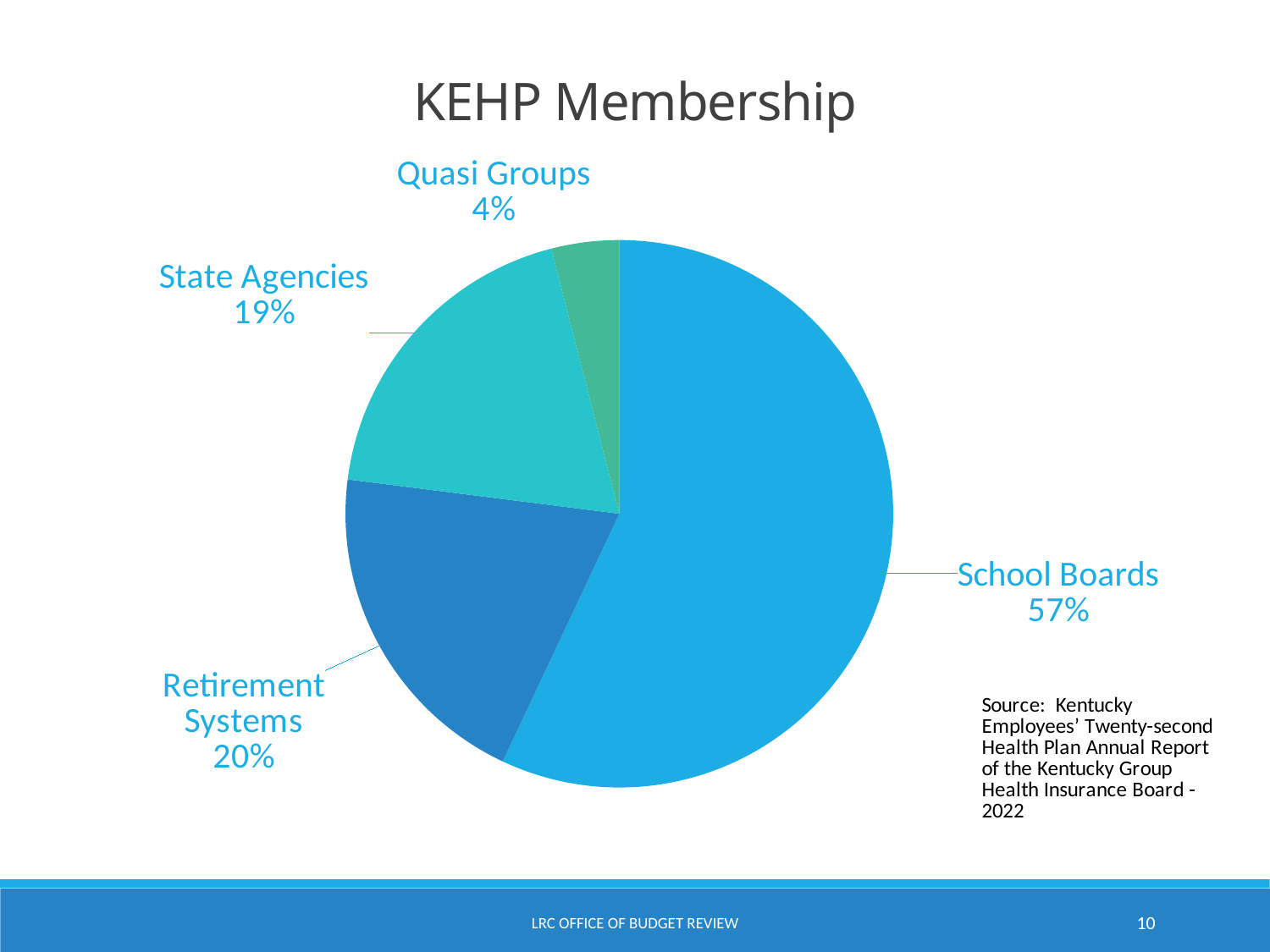
What is the title of the chart on the slide? KEHP Membership What share of KEHP membership is School Boards? 57% How many percentage points larger is the State Agencies share than the Quasi Groups share? 15 Which group has the largest share of KEHP membership? School Boards What kind of chart is used to show KEHP Membership? Pie chart How many percentage points larger is the School Boards share than the Retirement Systems share? 37 How many groups are shown in the KEHP Membership pie chart? 4 What share of KEHP membership is Retirement Systems? 20% Which group has the smallest share of KEHP membership? Quasi Groups What share of KEHP membership is State Agencies? 19% Which has a larger share of KEHP membership, Retirement Systems or State Agencies? Retirement Systems What share of KEHP membership is Quasi Groups? 4%